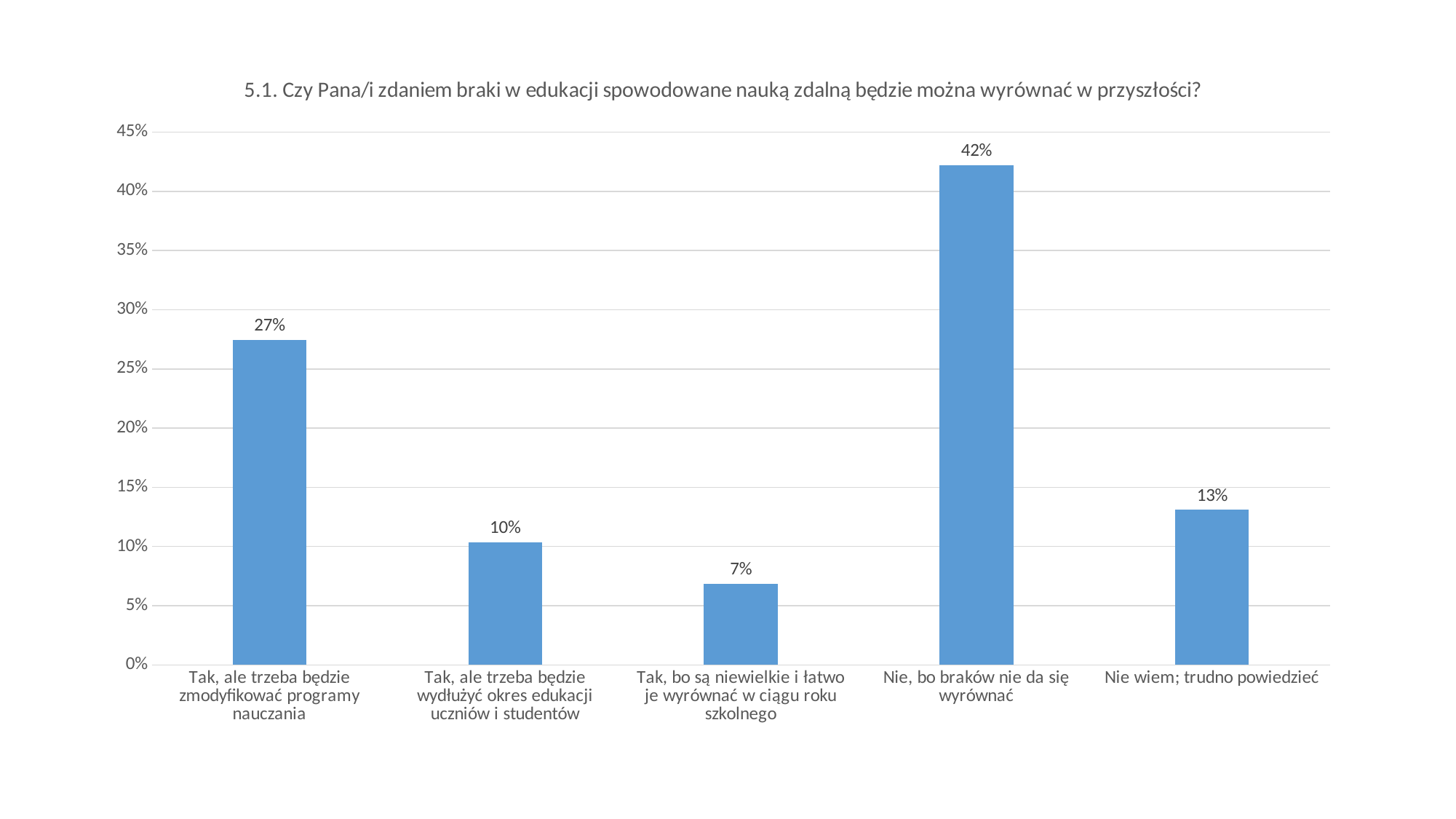
How many answer categories are shown in the chart? 5 What is the difference between the values for "Nie, bo braków nie da się wyrównać" and "Tak, ale trzeba będzie zmodyfikować programy nauczania"? 15% Is the value for "Tak, ale trzeba będzie zmodyfikować programy nauczania" greater or less than 25%? greater Which answer category has the lowest value? Tak, bo są niewielkie i łatwo je wyrównać w ciągu roku szkolnego What percentage of respondents answered "Nie, bo braków nie da się wyrównać"? 42% Which is larger: the value for "Nie wiem; trudno powiedzieć" or for "Tak, ale trzeba będzie wydłużyć okres edukacji uczniów i studentów"? Nie wiem; trudno powiedzieć What is the value for "Nie wiem; trudno powiedzieć"? 13% What is the title of the chart? 5.1. Czy Pana/i zdaniem braki w edukacji spowodowane nauką zdalną będzie można wyrównać w przyszłości? What is the value for "Tak, ale trzeba będzie zmodyfikować programy nauczania"? 27% What type of chart is shown on the slide? bar chart Which answer category has the highest value? Nie, bo braków nie da się wyrównać What is the value for "Tak, bo są niewielkie i łatwo je wyrównać w ciągu roku szkolnego"? 7%